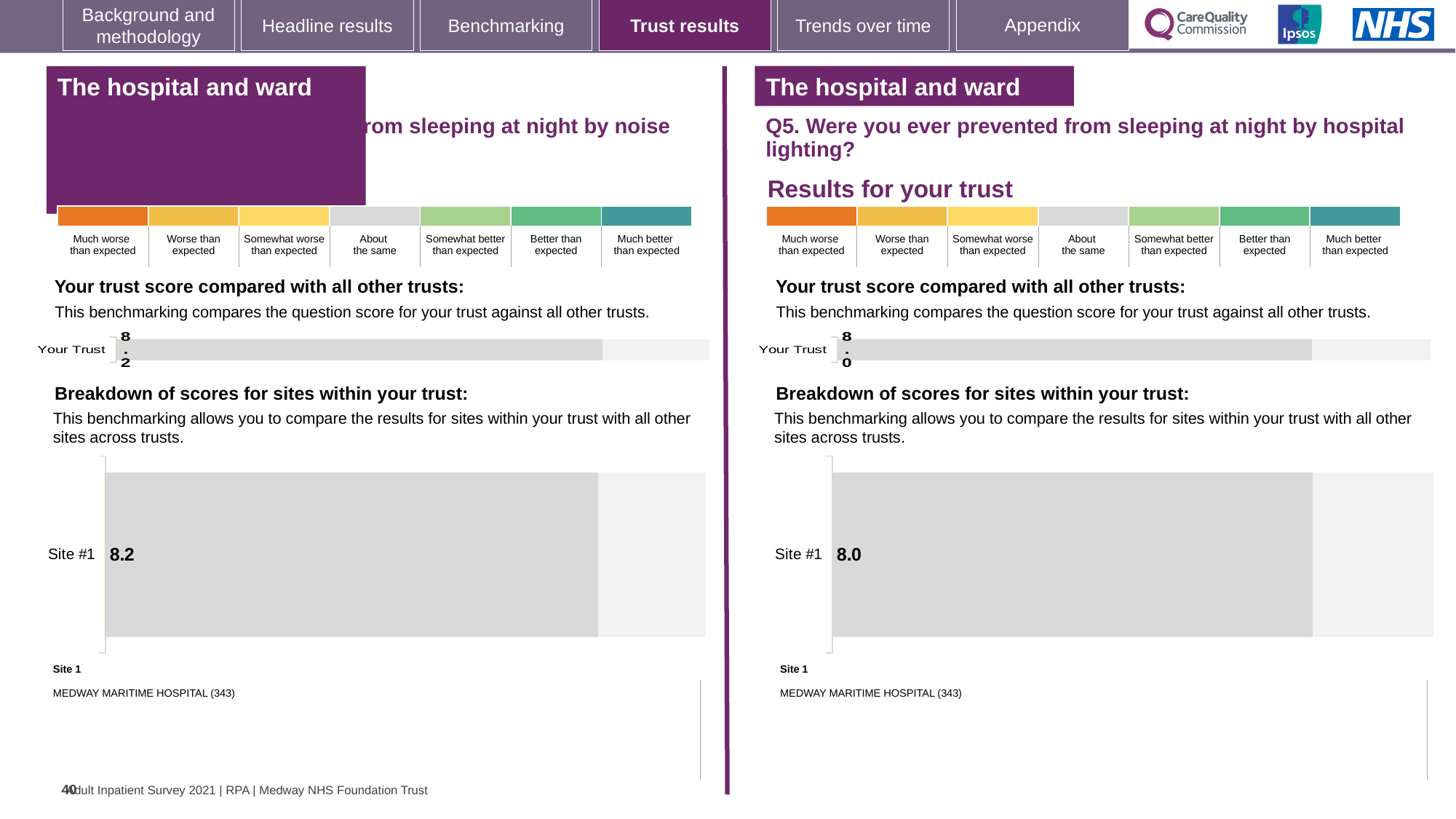
On the left-hand side of the slide (the question about noise), what score is shown for Site #1 in the 'Breakdown of scores for sites within your trust' chart? 8.2 On the right-hand side of the slide (Q5, hospital lighting), what score is shown for Site #1 in the 'Breakdown of scores for sites within your trust' chart? 8.0 How many sites are shown in the 'Breakdown of scores for sites within your trust' chart on the right-hand side of the slide (Q5, hospital lighting)? 1 What is the difference between the Site #1 score on the left-hand chart (noise) and the Site #1 score on the right-hand chart (Q5, hospital lighting)? 0.2 Which is larger: the Your Trust score on the left-hand chart (noise) or the Your Trust score on the right-hand chart (Q5, hospital lighting)? Left-hand chart (noise), 8.2 How many categories does the colour key above the charts on the right-hand side of the slide (Q5, hospital lighting) list, from 'Much worse than expected' to 'Much better than expected'? 7 On the left-hand side of the slide (the question about noise), what is the score shown for Your Trust in the 'Your trust score compared with all other trusts' chart? 8.2 What type of chart is used for the 'Breakdown of scores for sites within your trust' on the left-hand side of the slide? Bar chart On the right-hand side of the slide (Q5, hospital lighting), which hospital is listed as Site 1 below the site breakdown chart? MEDWAY MARITIME HOSPITAL (343) On the left-hand side of the slide (noise), is the Site #1 score the same as the Your Trust score? Yes, both 8.2 On the right-hand side of the slide (Q5, hospital lighting), what is the score shown for Your Trust in the 'Your trust score compared with all other trusts' chart? 8.0